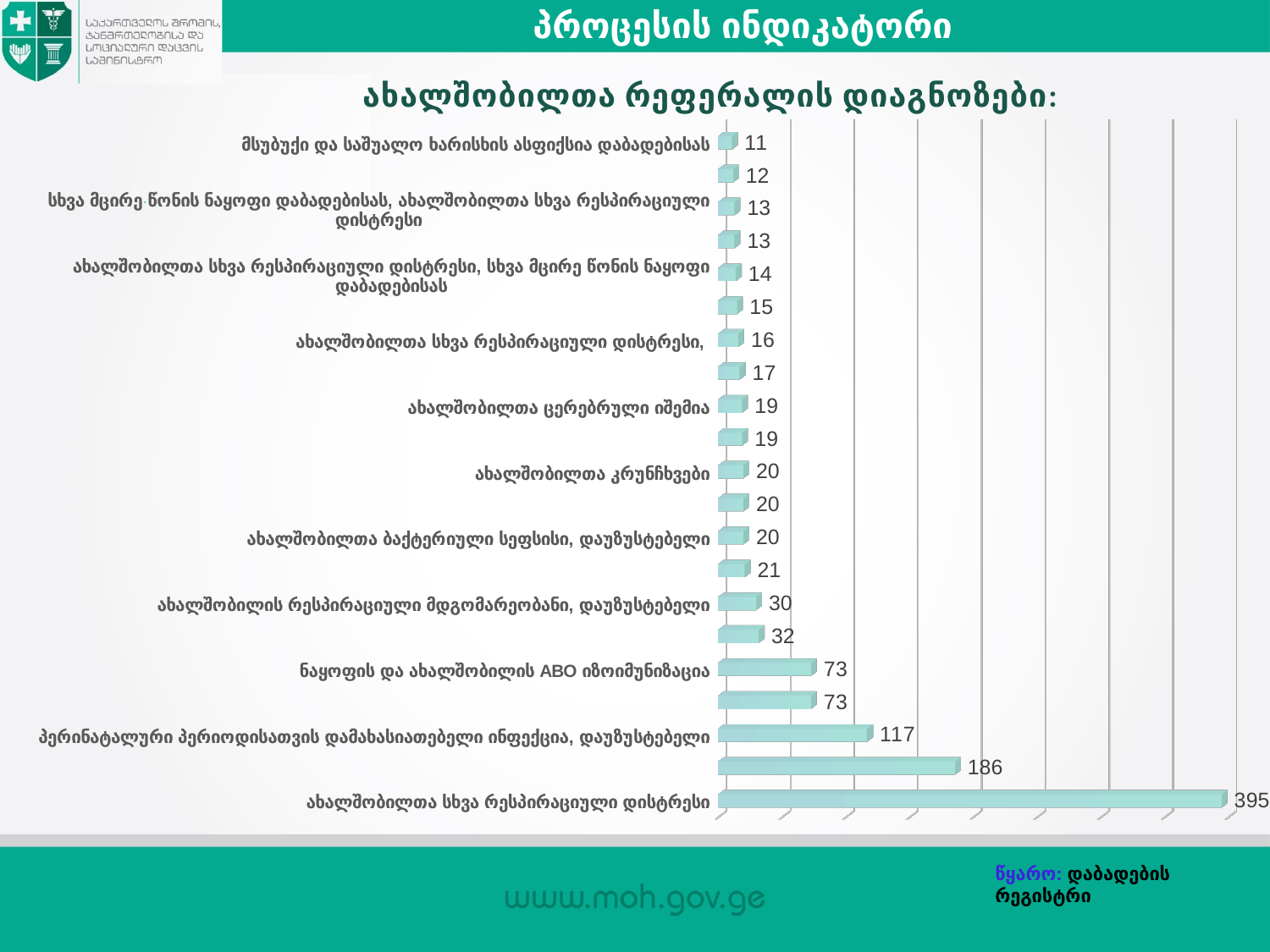
How many bars are plotted in the chart? 21 What is the title of the chart? ახალშობილთა რეფერალის დიაგნოზები: What is the value for ახალშობილის რესპირაციული მდგომარეობანი, დაუზუსტებელი? 30 What is the value for მსუბუქი და საშუალო ხარისხის ასფიქსია დაბადებისას? 11 What is the value for პერინატალური პერიოდისათვის დამახასიათებელი ინფექცია, დაუზუსტებელი? 117 What is the value for ნაყოფის და ახალშობილის ABO იზოიმუნიზაცია? 73 Which category has the lowest value in the chart? მსუბუქი და საშუალო ხარისხის ასფიქსია დაბადებისას What is the difference between the value for პერინატალური პერიოდისათვის დამახასიათებელი ინფექცია, დაუზუსტებელი and the value for ნაყოფის და ახალშობილის ABO იზოიმუნიზაცია? 44 What type of chart is shown on the slide? bar chart What is the highest value shown in the chart? 395 Which is larger: the value for ახალშობილთა კრუნჩხვები or the value for ახალშობილის რესპირაციული მდგომარეობანი, დაუზუსტებელი? ახალშობილის რესპირაციული მდგომარეობანი, დაუზუსტებელი What is the value for ახალშობილთა ცერებრული იშემია? 19